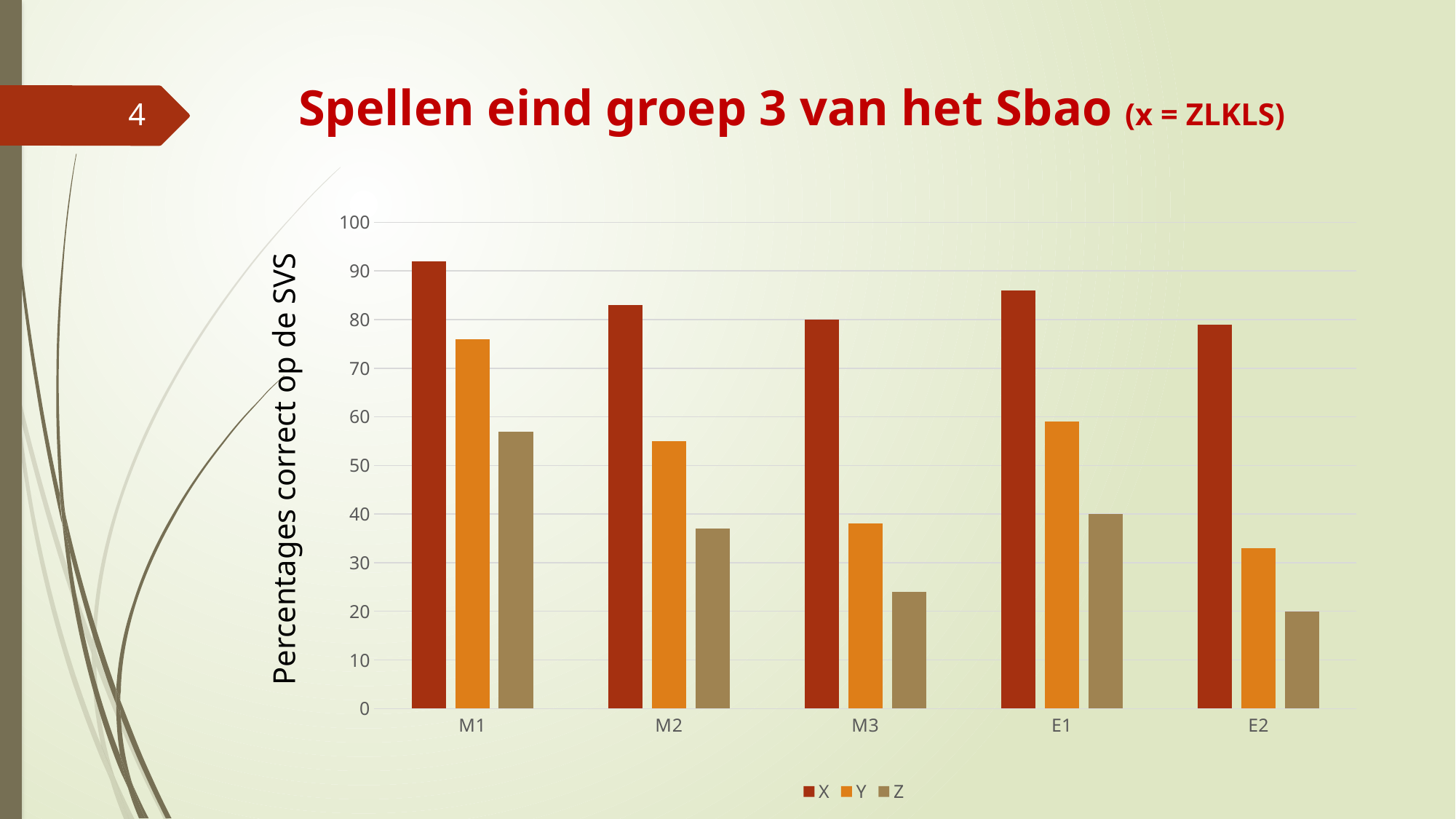
How many series does the legend list? 3 How many categories are shown on the x axis? 5 Is the value for series Y at E1 greater or less than 50? greater What kind of chart is shown on the slide? bar chart Which is larger: series X at M1 or series X at E1? series X at M1 Is the value for series X at M1 greater or less than 90? greater Which category has the lowest value for series Y? E2 Is the value for series Z at M3 greater or less than 30? less Which category has the highest value for series X? M1 Do the values for series Y rise or fall from M1 to M3? fall Which category has the highest value for series Y? M1 What is the label of the vertical axis? Percentages correct op de SVS